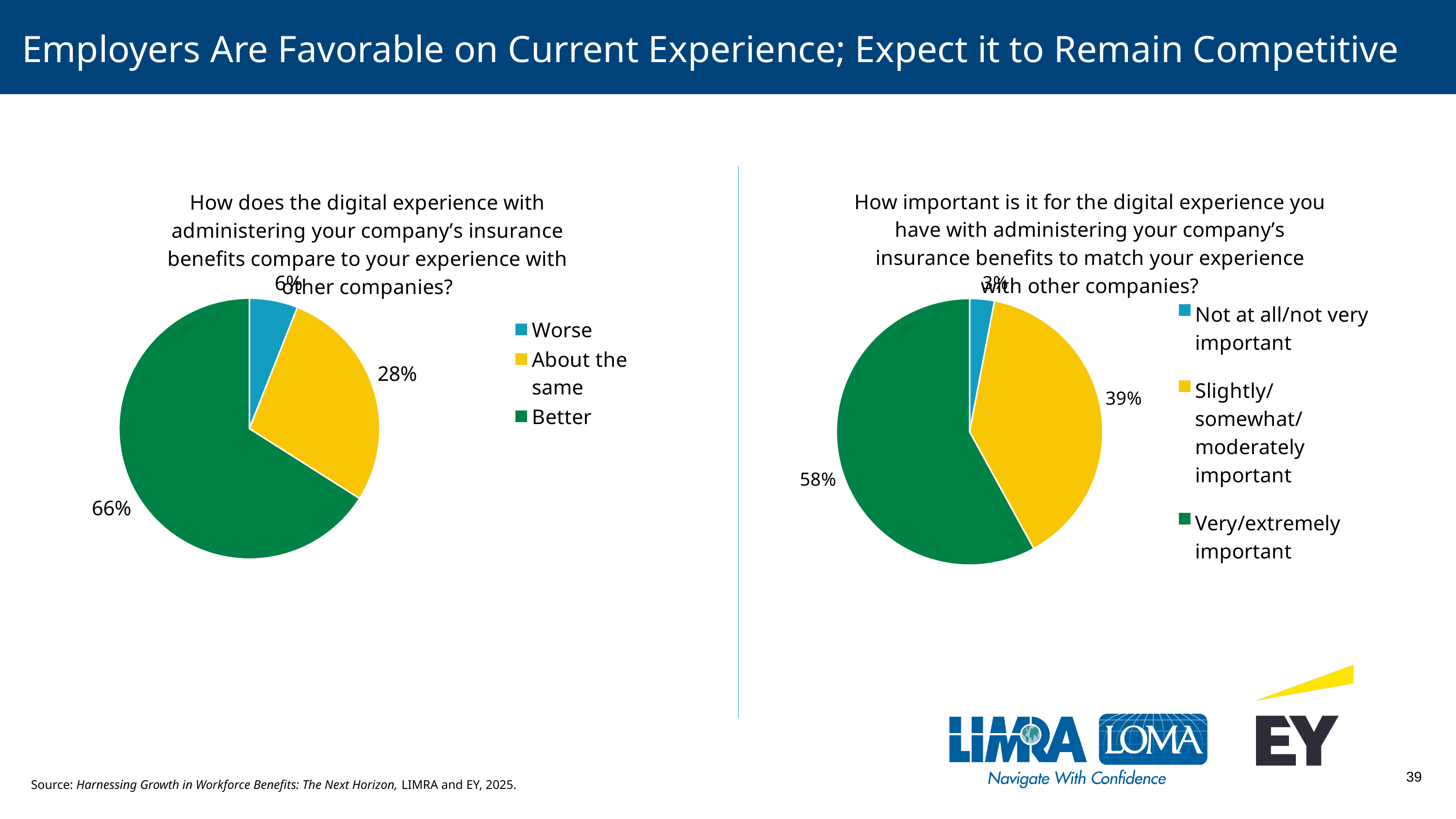
In the left pie chart, what percentage of employers said their digital experience is Better than with other companies? 66% In the left pie chart, what percentage of employers said their digital experience is Worse? 6% In the left pie chart, what is the difference in percentage points between Better and About the same? 38 In the left pie chart, which response has the largest share? Better In the right pie chart, which response has the smallest share? Not at all/not very important In the right pie chart, what percentage of employers said matching the digital experience is Very/extremely important? 58% In the left pie chart, which response has the smallest share? Worse In the right pie chart, which is larger: Very/extremely important or Slightly/somewhat/moderately important? Very/extremely important How many slices does the right pie chart have? 3 In the left pie chart, what percentage of employers said their digital experience is About the same? 28% What type of chart is used on the left side of the slide? Pie chart In the right pie chart, what percentage of employers said matching the digital experience is Slightly/somewhat/moderately important? 39%